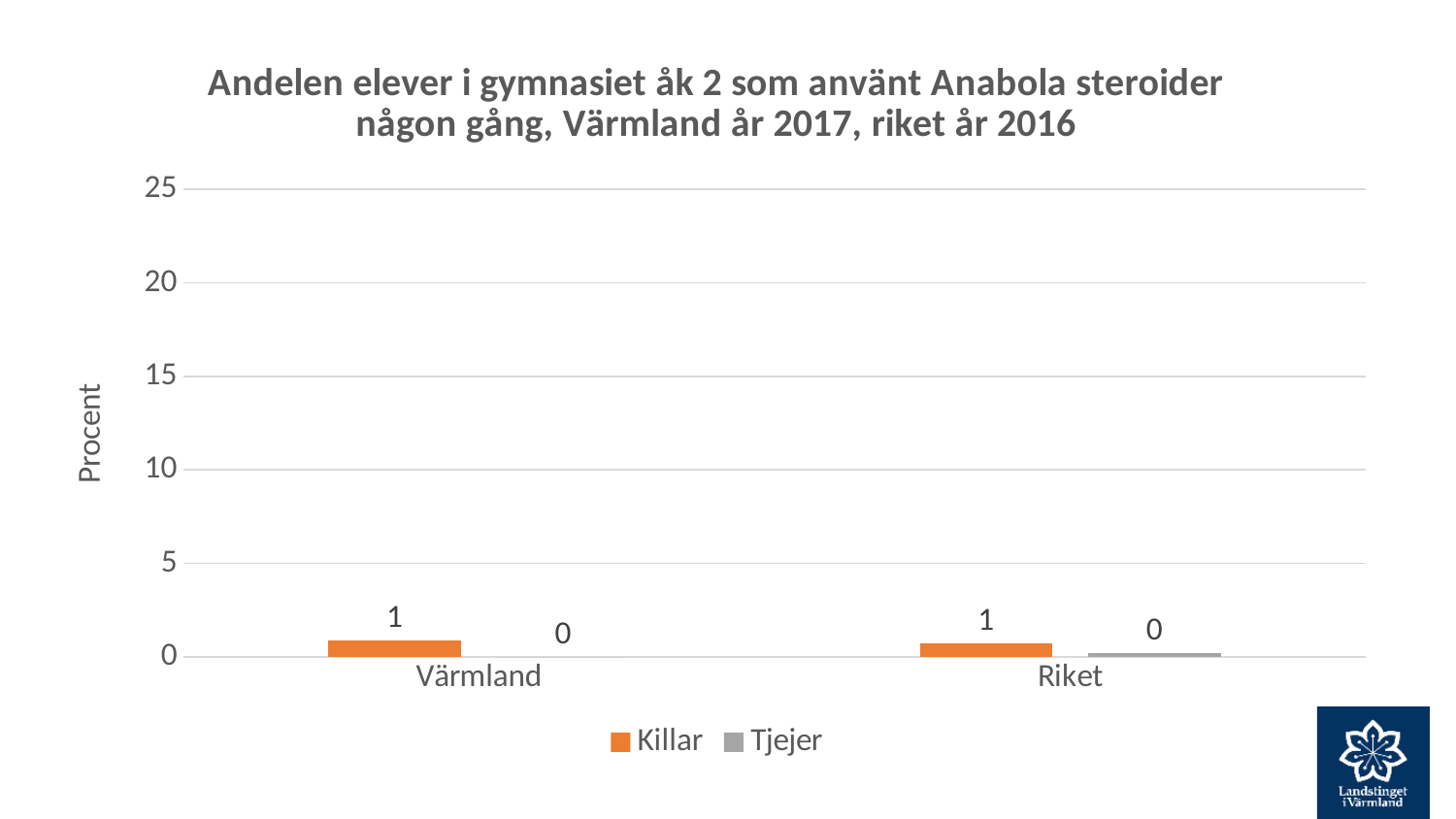
What is the difference between the Killar and Tjejer values in Riket? 1 Is the value for Killar in Värmland greater or less than 5? less In Värmland, which is larger, the value for Killar or the value for Tjejer? Killar What is the value for Killar in Riket? 1 What is the value for Killar in Värmland? 1 How many categories are shown on the x axis? 2 Which colour represents Killar in the legend? Orange What kind of chart is shown on the slide? Bar chart What is the value for Tjejer in Riket? 0 How many series does the legend list? 2 What is the value for Tjejer in Värmland? 0 What is the label on the y axis? Procent